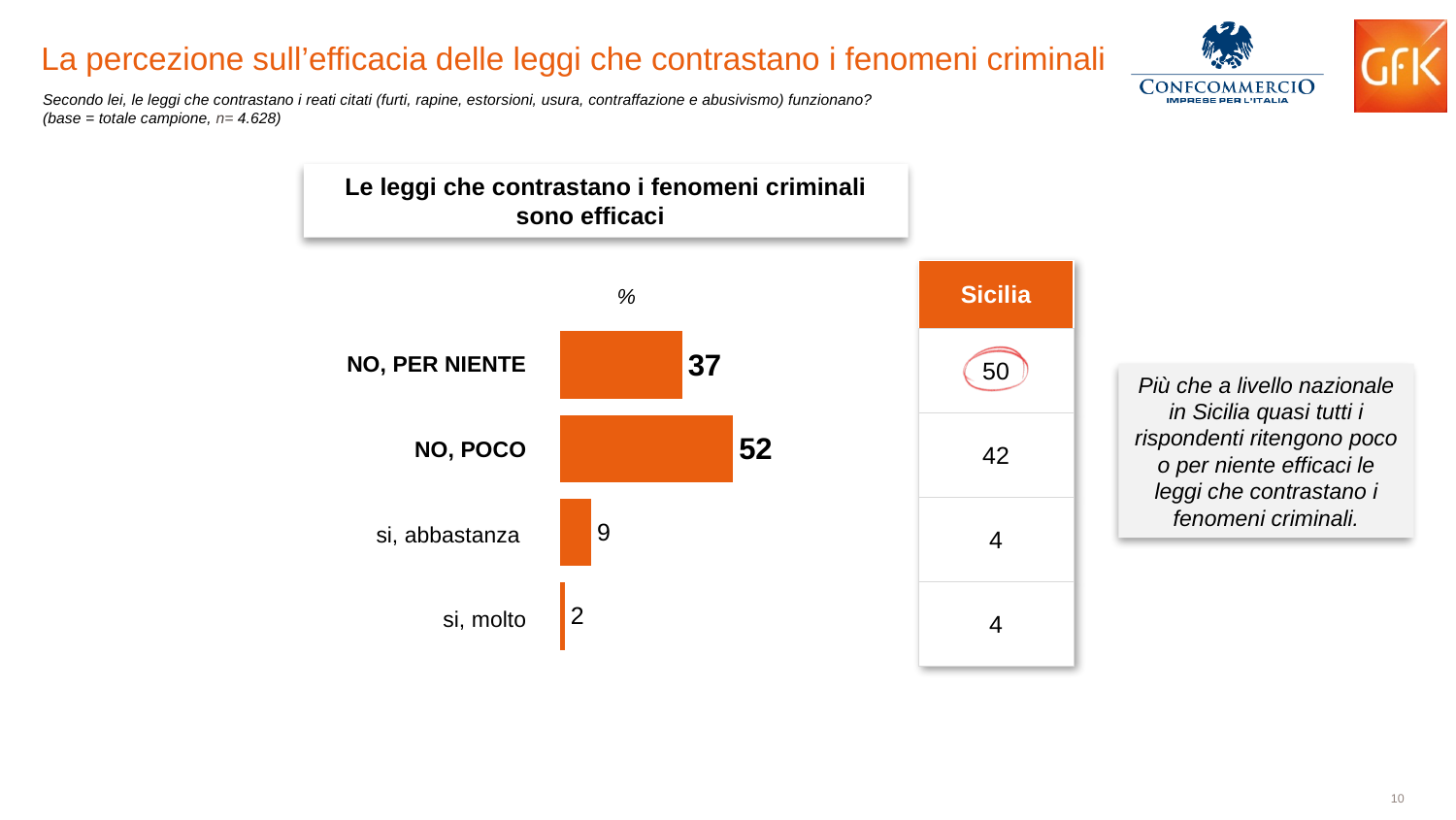
What is the value for "si, molto" in the bar chart? 2 What is the difference between the values for "NO, POCO" and "NO, PER NIENTE" in the bar chart? 15 What is the title of the chart on the slide? Le leggi che contrastano i fenomeni criminali sono efficaci How many categories are shown in the bar chart? 4 What is the value for "NO, PER NIENTE" in the bar chart? 37 What is the value for "NO, POCO" in the bar chart? 52 Which category has the lowest value in the bar chart? si, molto What is the difference between the values for "si, abbastanza" and "si, molto" in the bar chart? 7 What kind of chart is shown on the slide? Bar chart What is the value for "si, abbastanza" in the bar chart? 9 Which is larger in the bar chart, the value for "NO, PER NIENTE" or the value for "si, abbastanza"? NO, PER NIENTE Which category has the highest value in the bar chart? NO, POCO